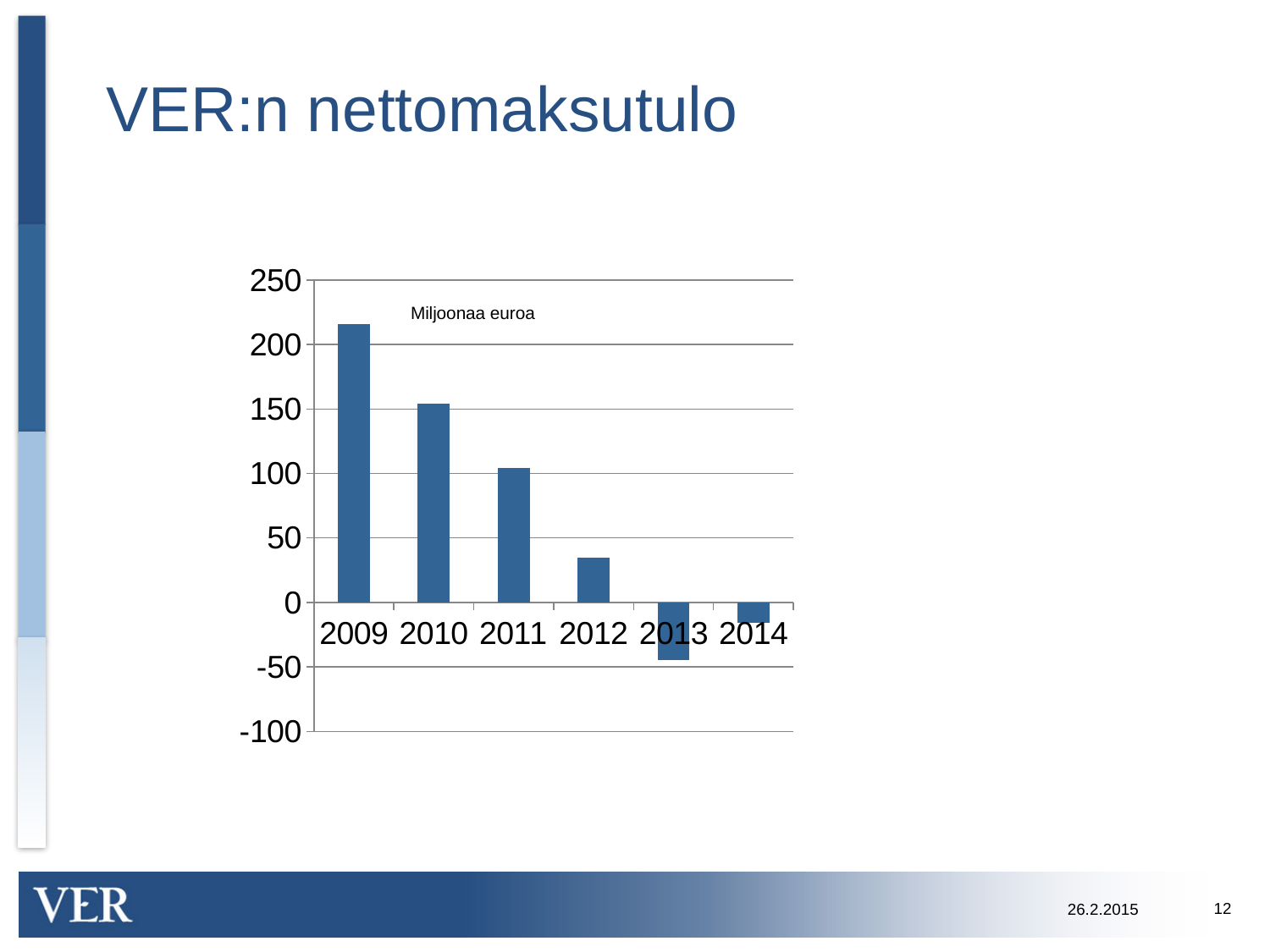
Which is larger, the value for 2011 or the value for 2012? 2011 How many years are shown on the x axis of the chart? 6 What kind of chart is shown on the slide? bar chart Which year has the highest value in the chart? 2009 Which year has the lowest value in the chart? 2013 What unit label is printed inside the chart area? Miljoonaa euroa Is the value for 2010 greater or less than 150? greater Do the values generally rise or fall from 2009 to 2013? fall Is the value for 2009 greater or less than 200? greater Is the value for 2012 greater or less than 50? less What is the title of the slide containing the chart? VER:n nettomaksutulo